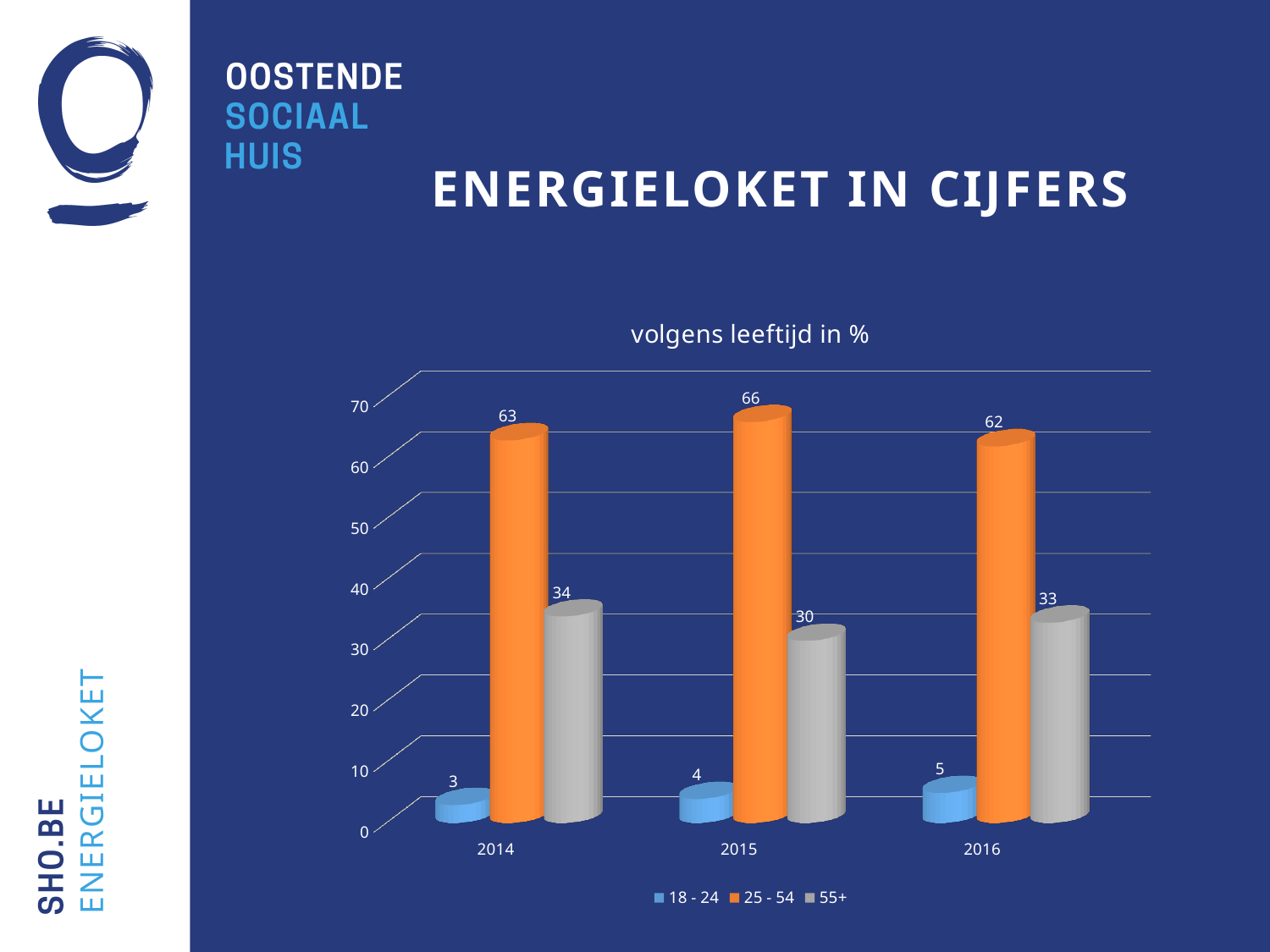
What is the value for the 18 - 24 series in 2016? 5 How many series does the legend list? 3 What kind of chart is shown? bar chart In which year is the 18 - 24 series lowest? 2014 How many years are shown on the x axis? 3 What is the title of the chart? volgens leeftijd in % What is the value for the 55+ series in 2014? 34 What is the difference between the 25 - 54 value and the 55+ value in 2016? 29 What is the value for the 25 - 54 series in 2015? 66 Is the value for 25 - 54 in 2014 greater or less than 60? greater In which year is the 25 - 54 series highest? 2015 Which is larger in 2015: the 55+ value or the 18 - 24 value? 55+